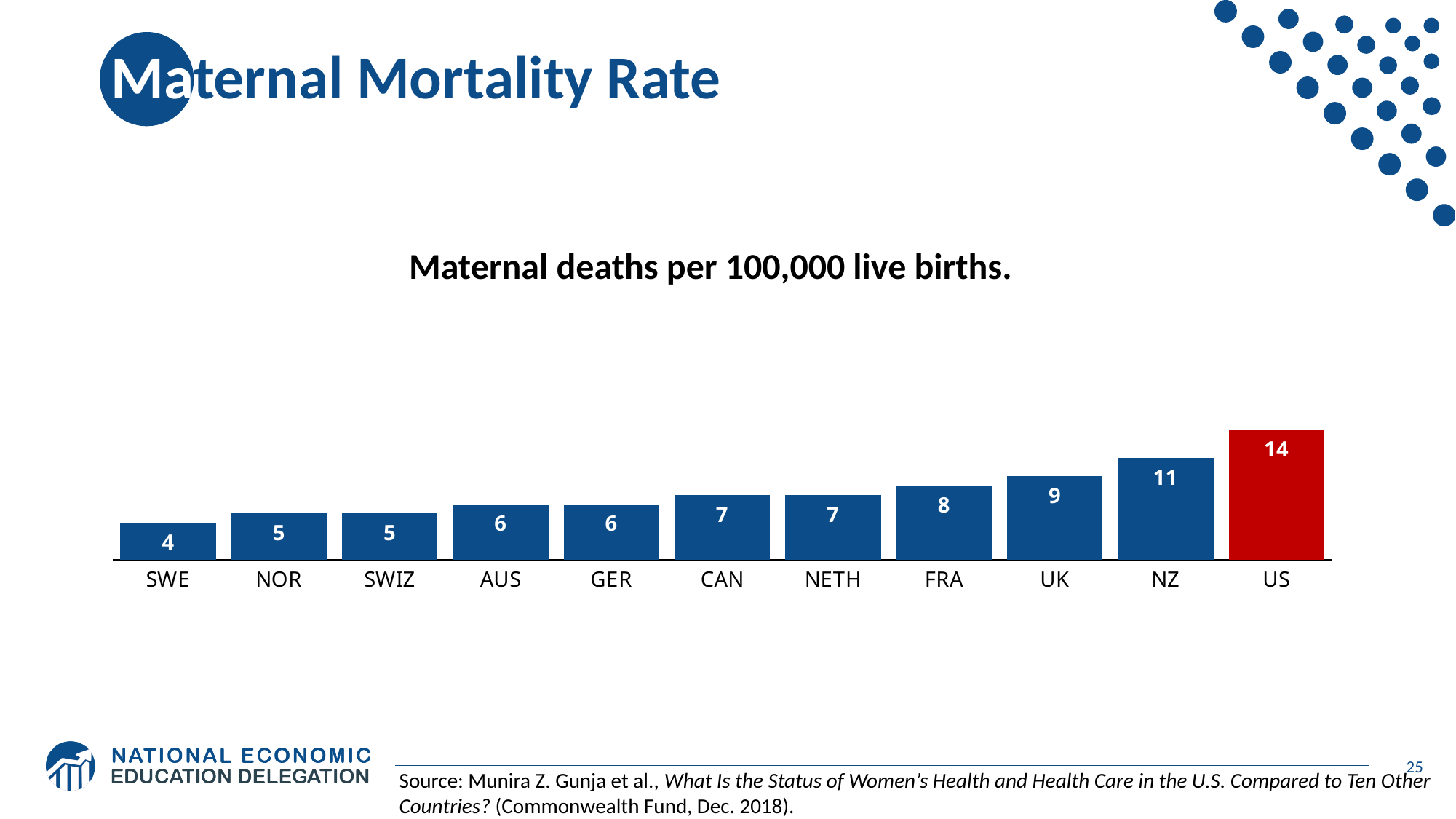
What value is shown for NZ? 11 Do the values rise or fall moving from left to right along the x axis? Rise Which country has the highest maternal mortality rate on the chart? US Which bar is coloured red rather than blue? US What value is shown for SWE? 4 What is the difference between the values for the US and the UK? 5 What kind of chart is shown on the slide? Bar chart Which has a higher value, FRA or AUS? FRA Which country has the lowest maternal mortality rate on the chart? SWE What is the difference between the values for NZ and SWE? 7 What is the maternal mortality rate shown for the US? 14 How many countries are shown on the chart? 11